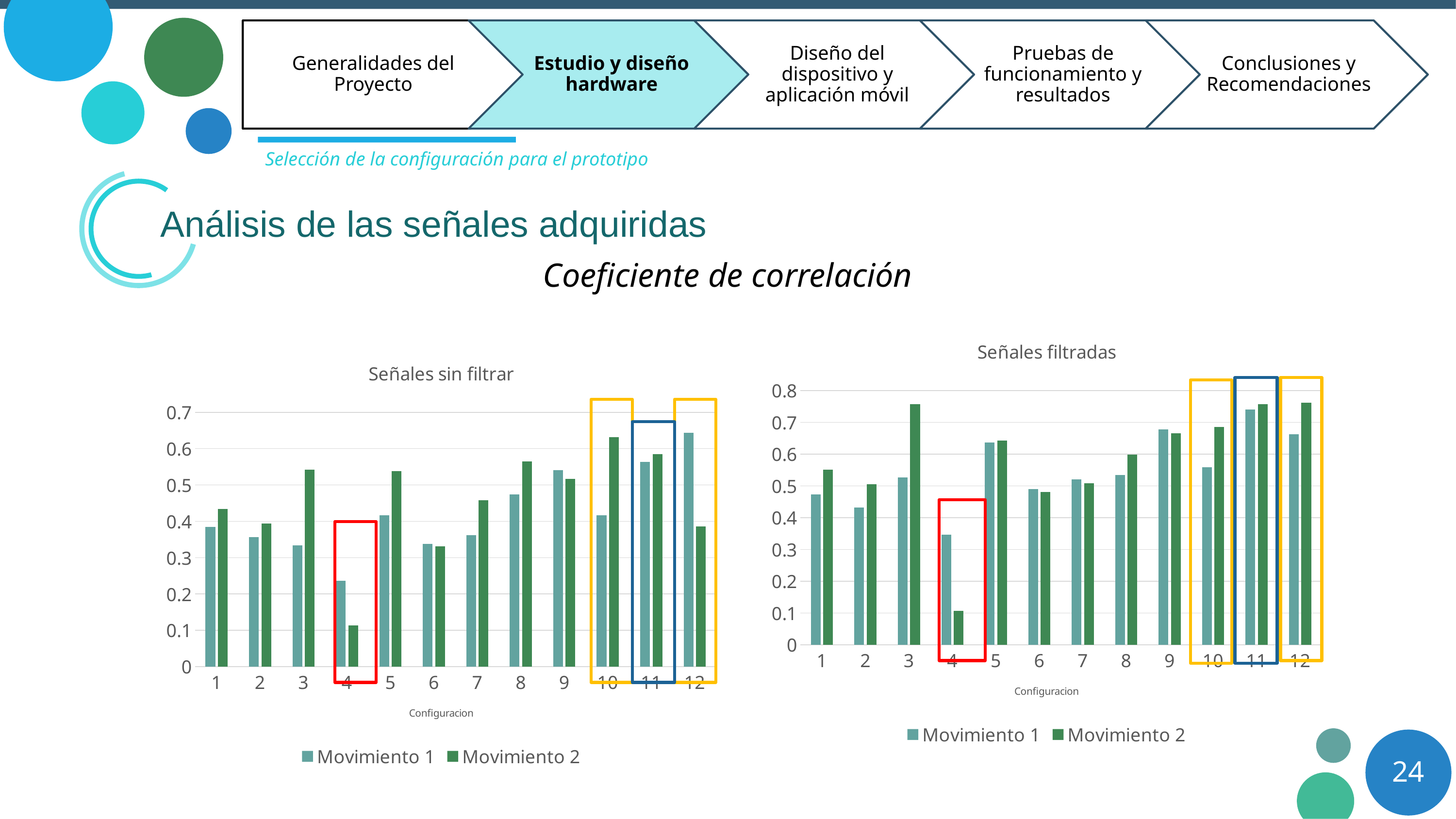
What kind of chart is the "Señales sin filtrar" chart on the left? Bar chart In the "Señales filtradas" chart, is the Movimiento 2 value for configuration 3 greater or less than 0.7? greater What is the x-axis label of the "Señales filtradas" chart? Configuracion In the "Señales sin filtrar" chart, is the Movimiento 2 value for configuration 3 greater or less than 0.5? greater How many configurations are shown on the x axis of the "Señales filtradas" chart? 12 In the "Señales filtradas" chart, is the Movimiento 1 value for configuration 11 greater or less than 0.7? greater In the "Señales filtradas" chart, which configuration has the lowest Movimiento 2 value? 4 In the "Señales sin filtrar" chart, which configuration has the lowest Movimiento 2 value? 4 How many series does the legend of the "Señales sin filtrar" chart list? 2 In the "Señales filtradas" chart, for configuration 3, which series has the larger value, Movimiento 1 or Movimiento 2? Movimiento 2 In the "Señales sin filtrar" chart, for configuration 12, which series has the larger value, Movimiento 1 or Movimiento 2? Movimiento 1